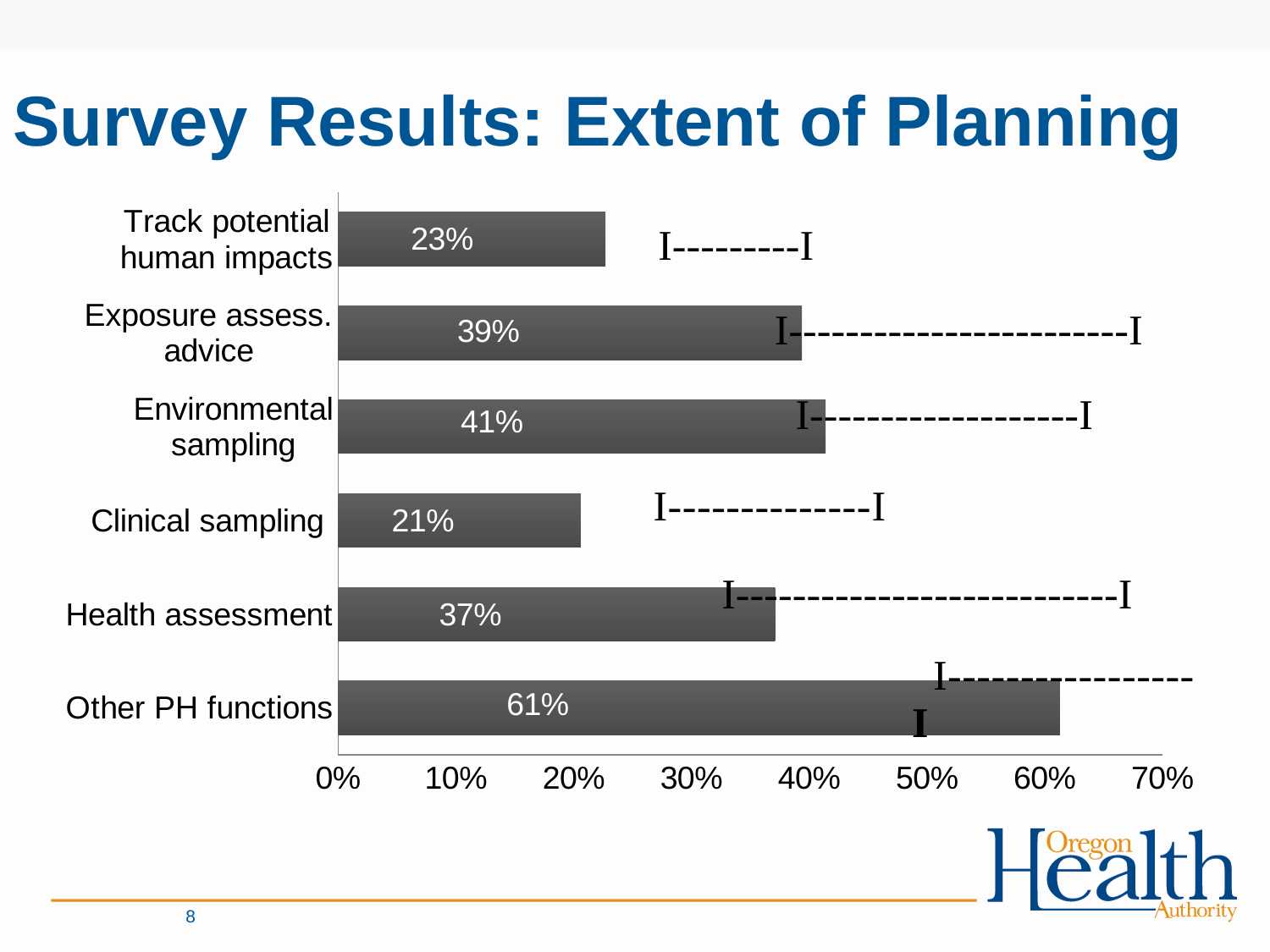
What is the difference between the values for Other PH functions and Health assessment? 24% Which is larger, the value for Health assessment or the value for Clinical sampling? Health assessment What is the difference between the values for Exposure assess. advice and Track potential human impacts? 16% Which category has the highest value? Other PH functions What is the value for Environmental sampling? 41% What is the value for Clinical sampling? 21% Is the value for Exposure assess. advice greater or less than 30%? greater How many categories are shown in the chart? 6 What is the value for Track potential human impacts? 23% What is the value for Other PH functions? 61% What kind of chart is shown on the slide? Bar chart Which category has the lowest value? Clinical sampling